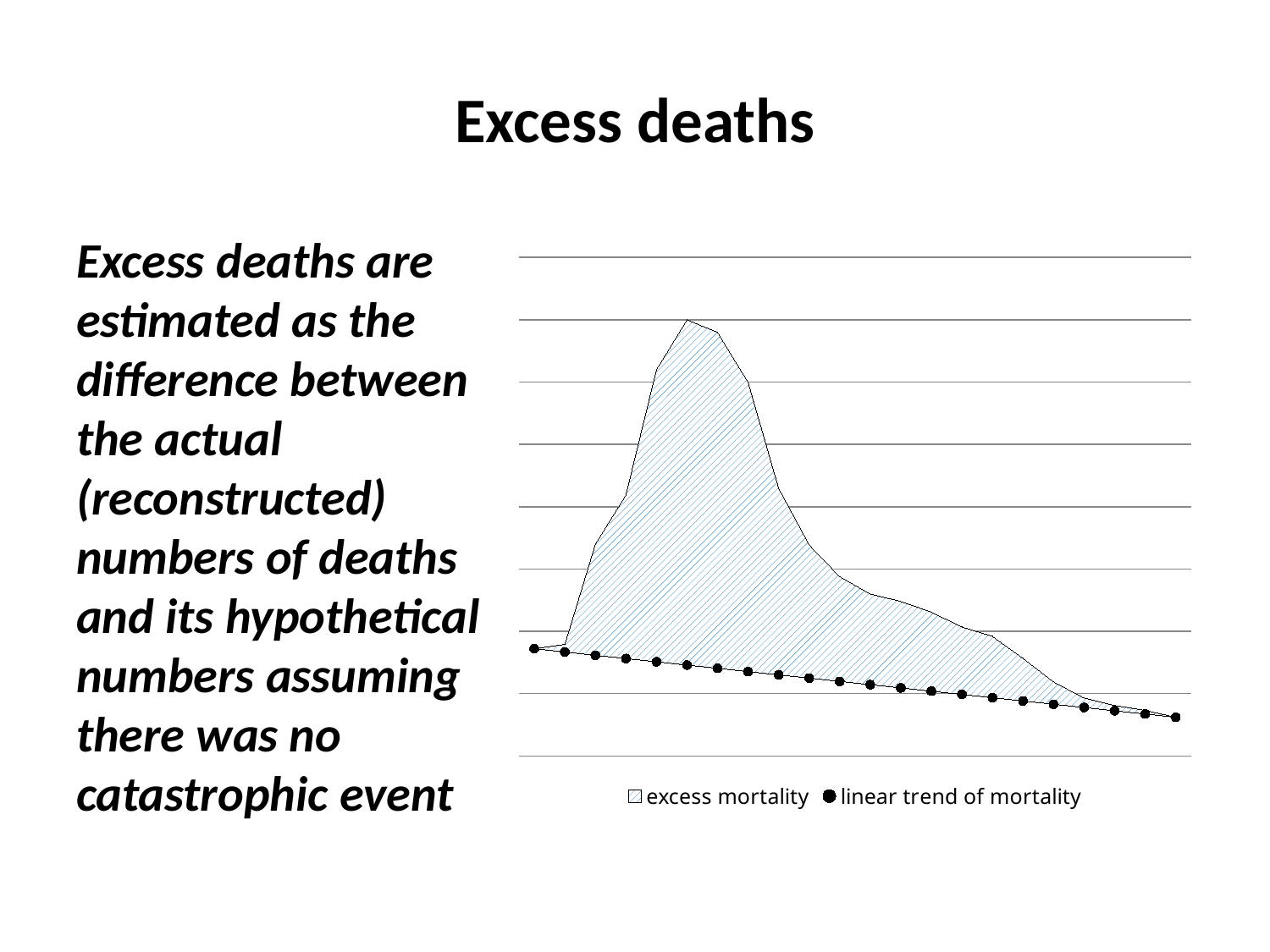
Is the peak of the 'excess mortality' area located in the left half or the right half of the chart? left half Does the 'linear trend of mortality' series rise or fall along the x axis? fall What kind of chart is shown on the slide? area chart with a line What are the two series named in the chart legend? excess mortality; linear trend of mortality How many series does the chart legend list? 2 Does the 'excess mortality' area rise steadily, fall steadily, or rise and then fall along the x axis? rise and then fall Which series is drawn with black dots? linear trend of mortality